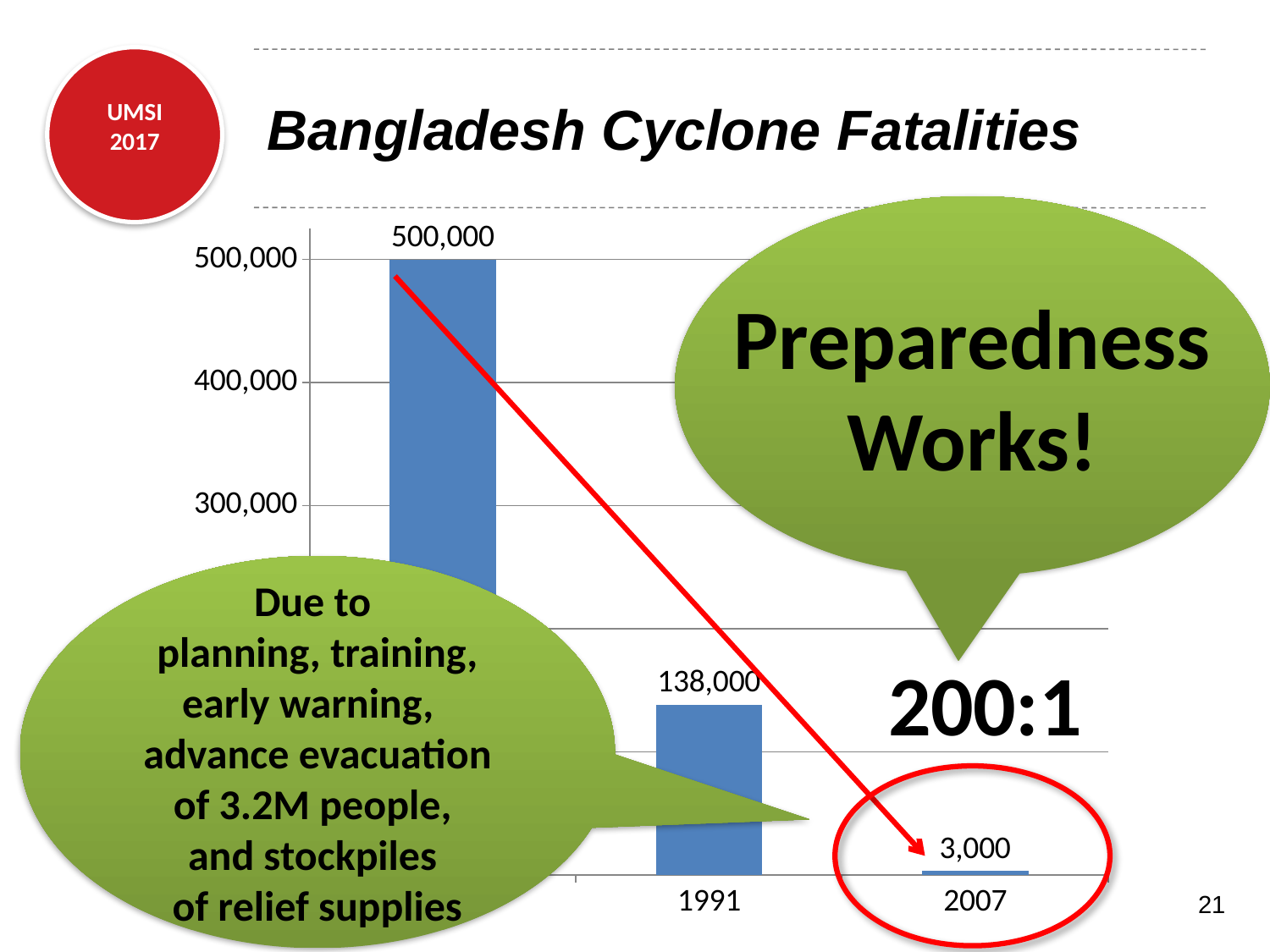
Which year has the lowest fatalities in the chart? 2007 What is the difference between the tallest bar's value and the value for 2007? 497,000 How many bars are plotted in the chart? 3 Which is larger, the value for 1991 or the value for 2007? 1991 What is the value for 2007 in the Bangladesh Cyclone Fatalities chart? 3,000 Is the value for 1991 greater or less than 100,000? greater What kind of chart is shown on the slide? bar chart What is the value of the tallest bar in the chart? 500,000 Do the values rise or fall from left to right along the x axis? fall What is the value for 1991 in the Bangladesh Cyclone Fatalities chart? 138,000 What is the difference between the values for 1991 and 2007? 135,000 What is the title of the chart? Bangladesh Cyclone Fatalities